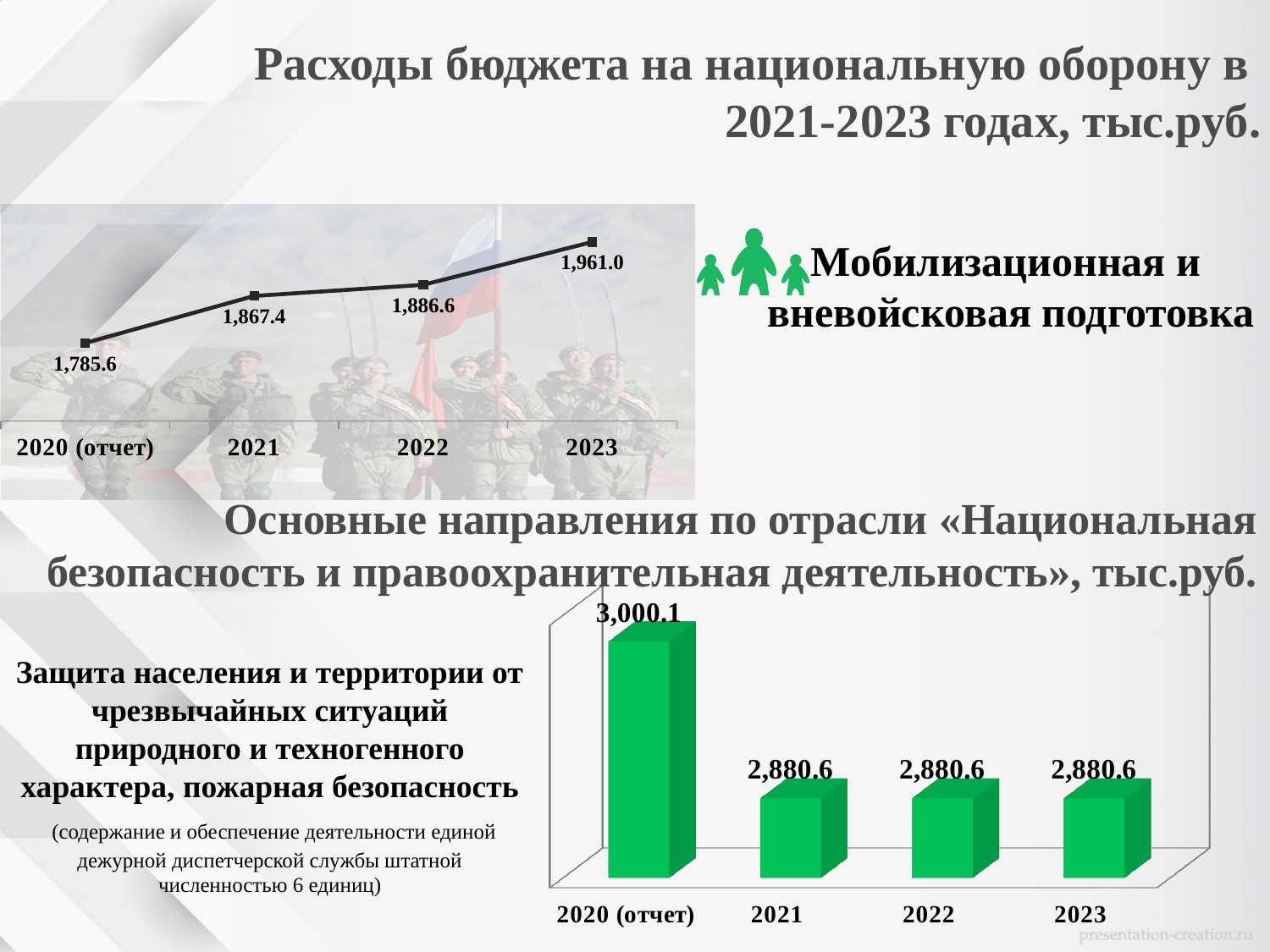
In the top line chart on national defence expenditures, what is the difference between the 2023 value and the 2022 value? 74.4 In the top line chart on national defence expenditures, which year has the highest value? 2023 What kind of chart is the top chart on national defence expenditures? line chart In the top line chart on national defence expenditures, what is the value for 2020 (отчет)? 1,785.6 How many bars are shown in the bottom bar chart on national security and law enforcement? 4 In the bottom bar chart on national security and law enforcement, which year has the highest value? 2020 (отчет) In the bottom bar chart on national security and law enforcement, what is the difference between the 2020 (отчет) value and the 2021 value? 119.5 In the top line chart on national defence expenditures, which year has the lowest value? 2020 (отчет) In the top line chart on national defence expenditures, what is the value for 2021? 1,867.4 In the bottom bar chart on national security and law enforcement, what is the value for 2022? 2,880.6 In the bottom bar chart on national security and law enforcement, what is the value for 2020 (отчет)? 3,000.1 In the top line chart on national defence expenditures, do the values rise or fall from 2020 (отчет) to 2023? rise